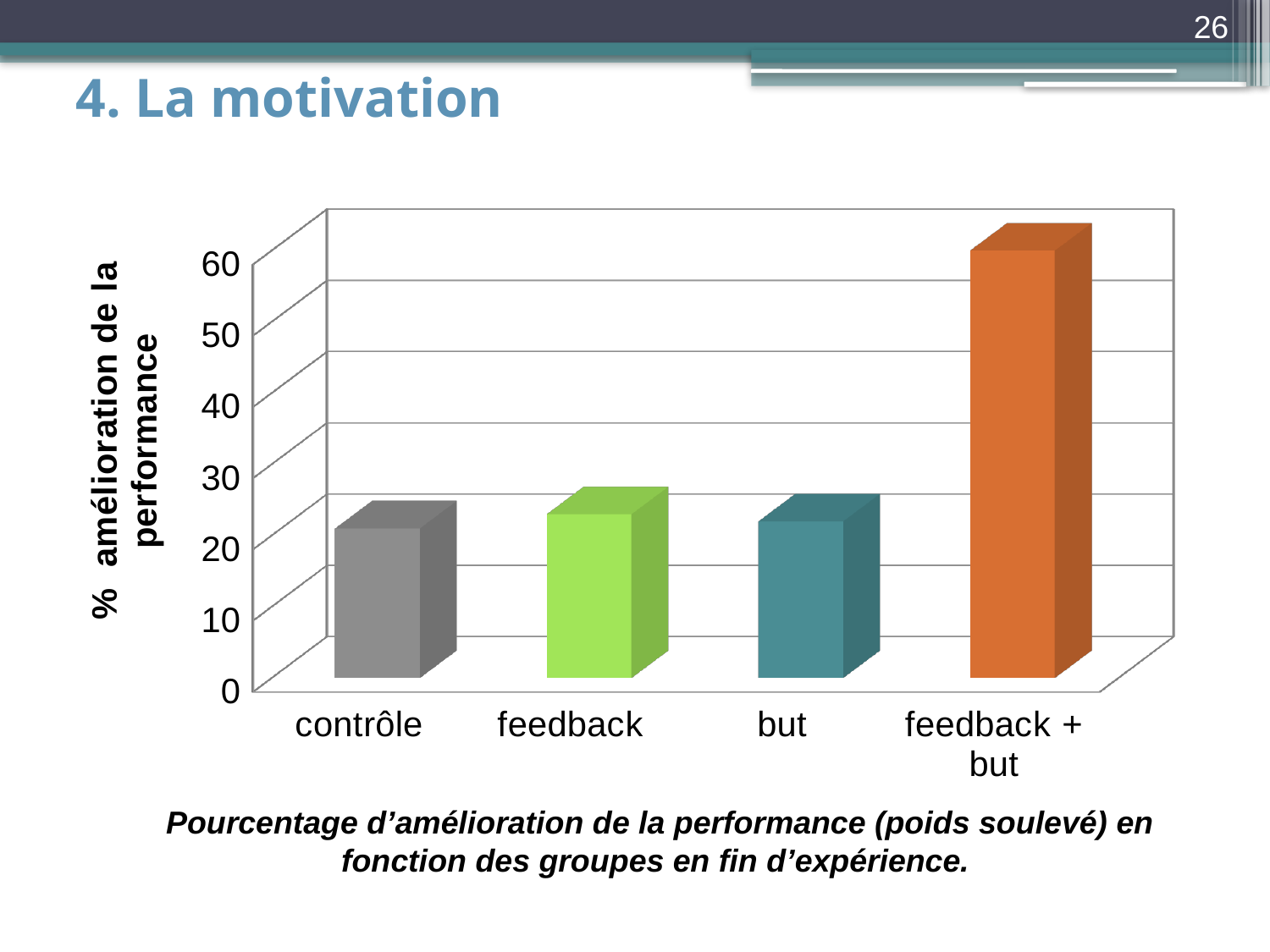
Which is larger, the value for 'feedback + but' or the value for 'but'? feedback + but What kind of chart is shown on the slide? bar chart Is the value for the 'feedback + but' group greater or less than 50? greater Is the value for the 'but' group greater or less than 40? less How many categories (groups) are shown on the x axis of the chart? 4 Is the value for the 'feedback' group greater or less than 30? less What is the label of the vertical axis of the chart? % amélioration de la performance Which is larger, the value for 'feedback + but' or the value for 'feedback'? feedback + but What is the highest tick value shown on the vertical axis? 60 Which group has the highest percentage of performance improvement? feedback + but